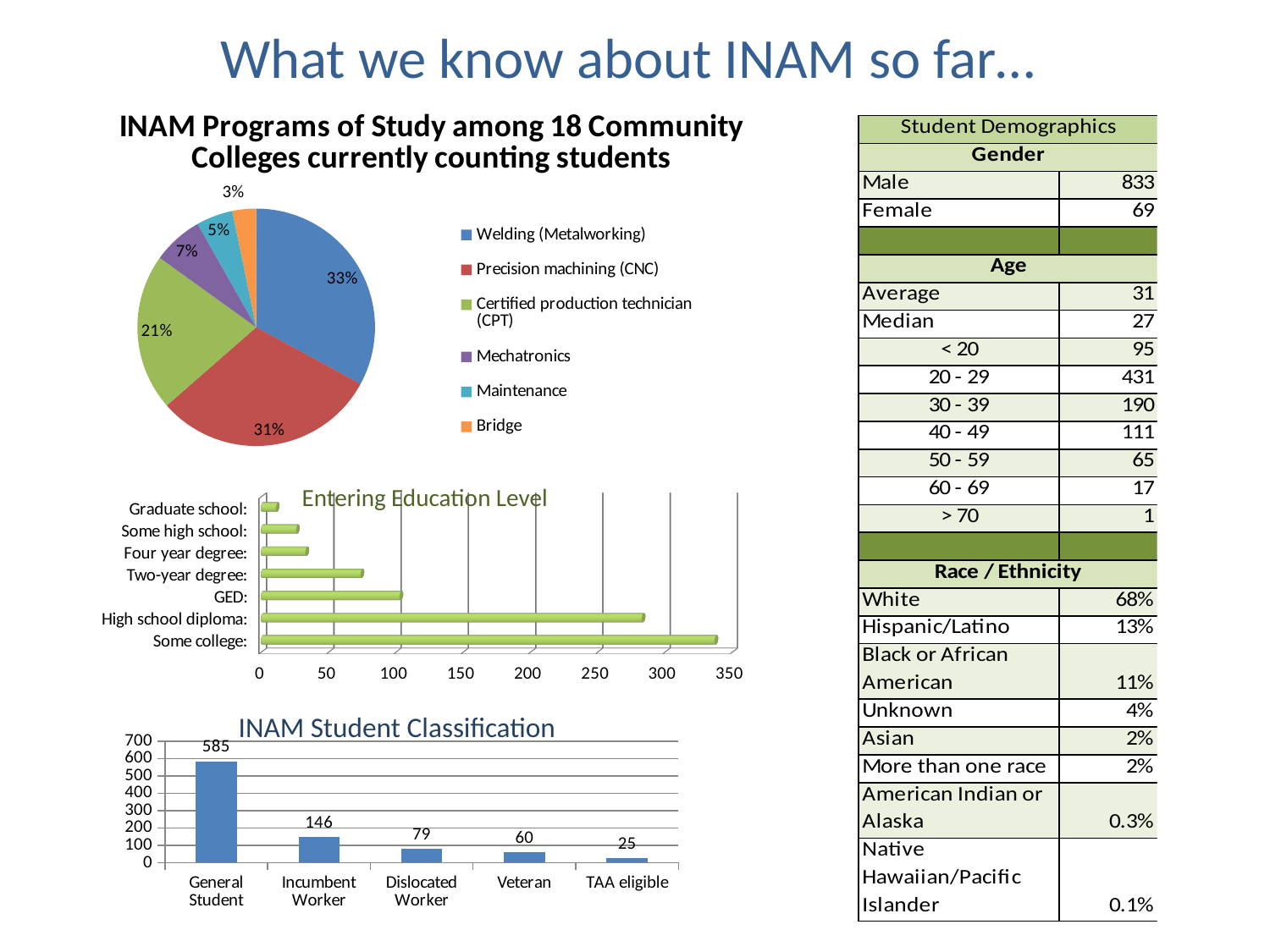
In the 'Entering Education Level' chart, which category has the highest value? Some college In the 'INAM Student Classification' chart, what is the difference between General Student and TAA eligible? 560 In the 'Entering Education Level' chart, is the value for High school diploma greater or less than 250? greater In the pie chart 'INAM Programs of Study among 18 Community Colleges currently counting students', what share is Welding (Metalworking)? 33% In the 'Entering Education Level' chart, is the value for Two-year degree greater or less than 100? less In the 'INAM Student Classification' chart, what is the value for Incumbent Worker? 146 In the pie chart 'INAM Programs of Study among 18 Community Colleges currently counting students', which program has the smallest share? Bridge What kind of chart is 'Entering Education Level'? Bar chart In the pie chart 'INAM Programs of Study among 18 Community Colleges currently counting students', what is the difference between the Precision machining (CNC) share and the Mechatronics share? 24% How many entries does the legend of the pie chart 'INAM Programs of Study among 18 Community Colleges currently counting students' list? 6 How many categories are shown in the 'INAM Student Classification' chart? 5 In the pie chart 'INAM Programs of Study among 18 Community Colleges currently counting students', what share is Certified production technician (CPT)? 21%